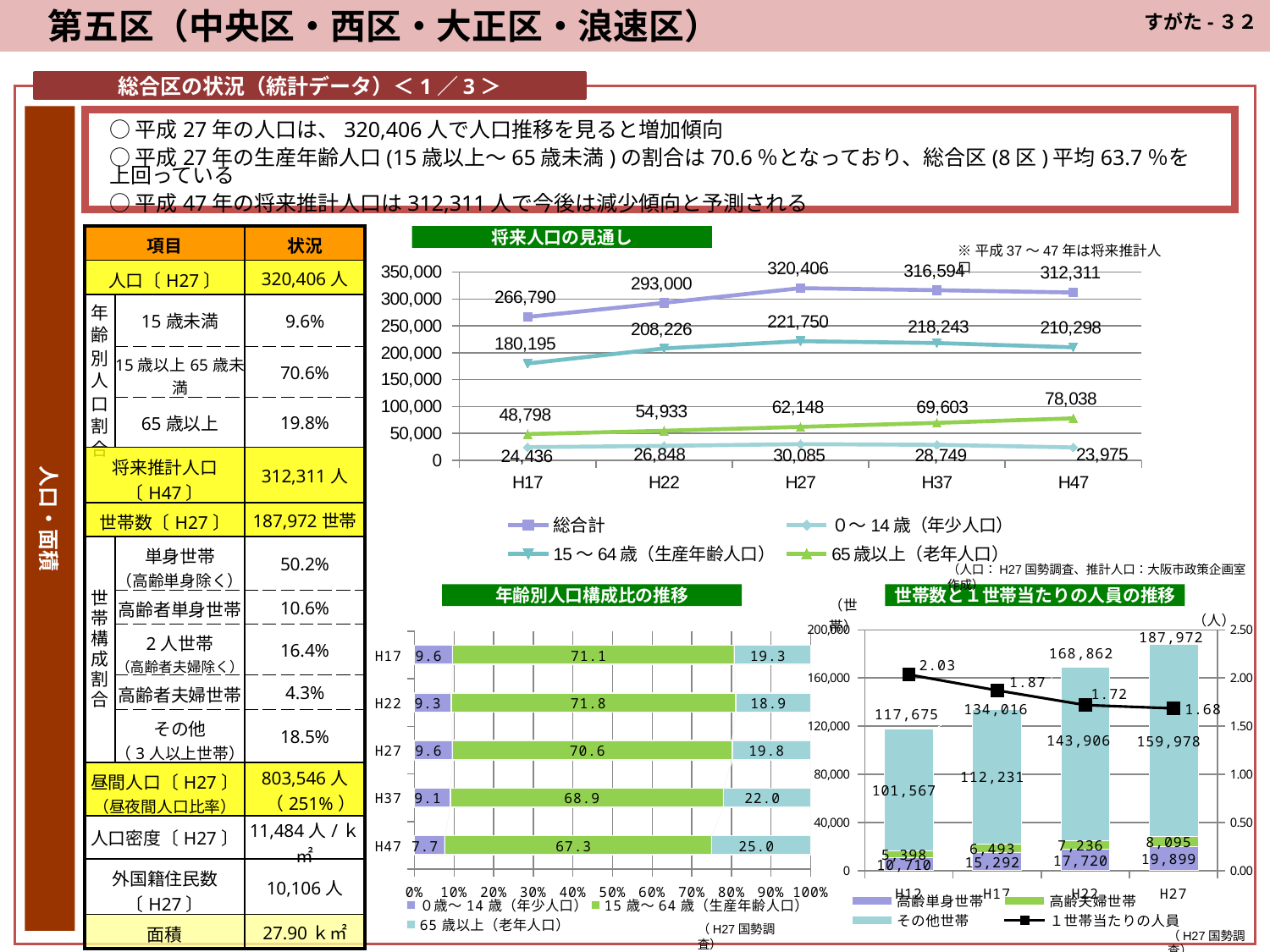
In the 世帯数と1世帯当たりの人員の推移 chart, what is the total number of households for H27? 187,972 In the 将来人口の見通し chart, in which year is the 総合計 highest? H27 In the 年齢別人口構成比の推移 chart, which year has the lowest value for 0歳～14歳（年少人口）? H47 In the 将来人口の見通し chart, how many series does the legend list? 4 What kind of chart is the 年齢別人口構成比の推移 chart? bar chart In the 年齢別人口構成比の推移 chart, what is the share of 15歳～64歳（生産年齢人口） for H37? 68.9 In the 世帯数と1世帯当たりの人員の推移 chart, how many years are shown on the x axis? 4 In the 将来人口の見通し chart, what is the value for 65歳以上（老年人口） in H47? 78,038 In the 将来人口の見通し chart, what is the difference between the 15～64歳 values for H27 and H47? 11,452 In the 将来人口の見通し chart, does the 65歳以上（老年人口） series rise or fall from H17 to H47? rise In the 世帯数と1世帯当たりの人員の推移 chart, what is the 1世帯当たりの人員 value for H12? 2.03 In the 将来人口の見通し chart, what is the 総合計 value for H27? 320,406